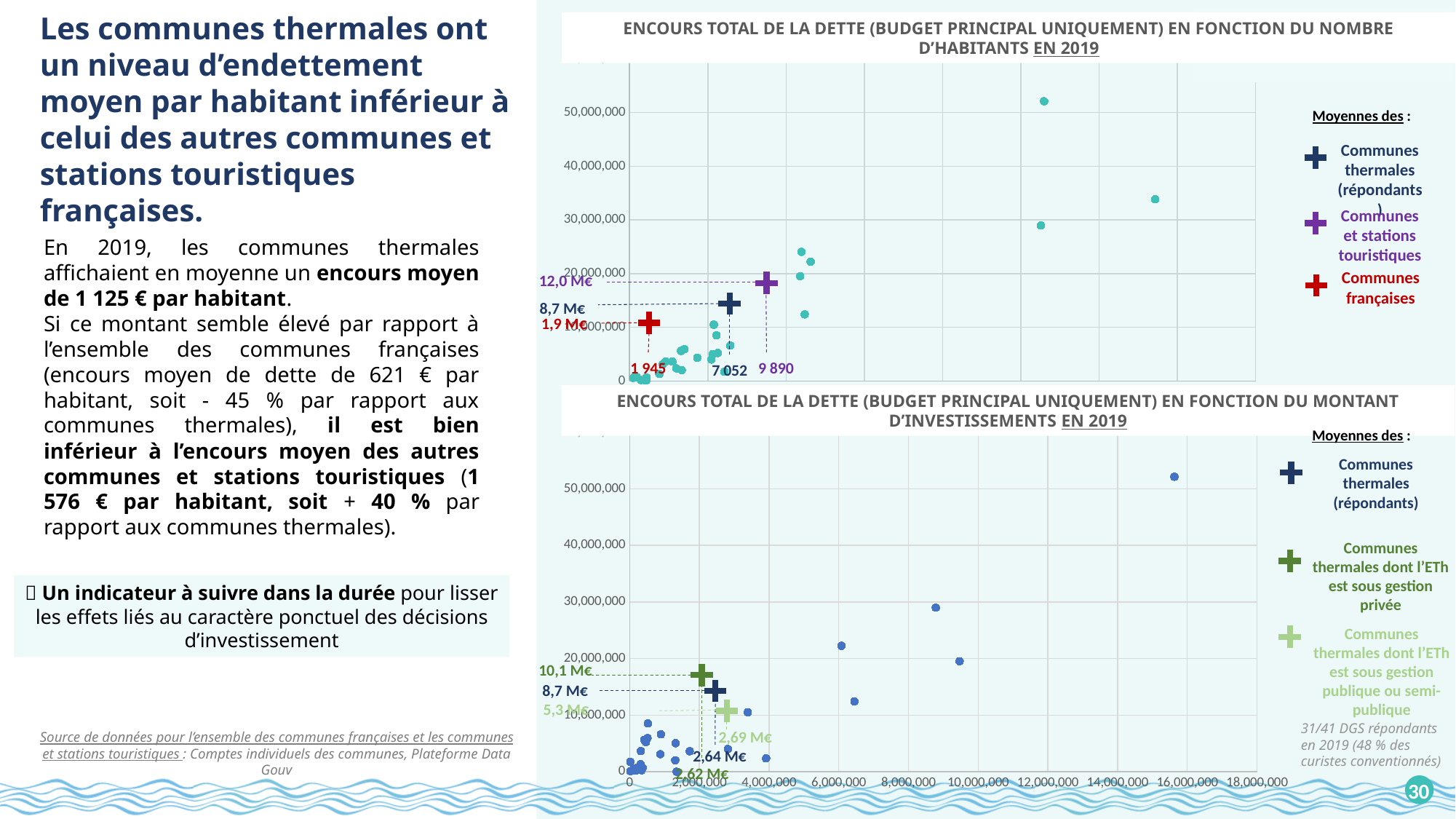
In the top chart, which group has the highest average debt? Communes et stations touristiques In the top chart, what is the average debt shown for the communes françaises? 1,9 M€ How many groups does the legend of the top chart list? 3 In the bottom chart, what is the average investment amount shown for the communes thermales dont l'ETh est sous gestion publique ou semi-publique? 2,69 M€ In the top chart (encours de la dette en fonction du nombre d'habitants), what is the average debt shown for the communes thermales (répondants)? 8,7 M€ In the bottom chart, which group has the lowest average debt? Communes thermales dont l'ETh est sous gestion publique ou semi-publique In the top chart, what is the average number of inhabitants shown for the communes françaises? 1 945 In the bottom chart (encours de la dette en fonction du montant d'investissements), what is the average debt shown for the communes thermales dont l'ETh est sous gestion privée? 10,1 M€ In the bottom chart, what is the difference between the average debt of communes thermales under private management and those under public or semi-public management? 4,8 M€ What kind of chart is the bottom chart? Scatter chart In the top chart, what is the average number of inhabitants shown for the communes et stations touristiques? 9 890 In the top chart, what is the difference between the average debt of the communes et stations touristiques and that of the communes thermales? 3,3 M€